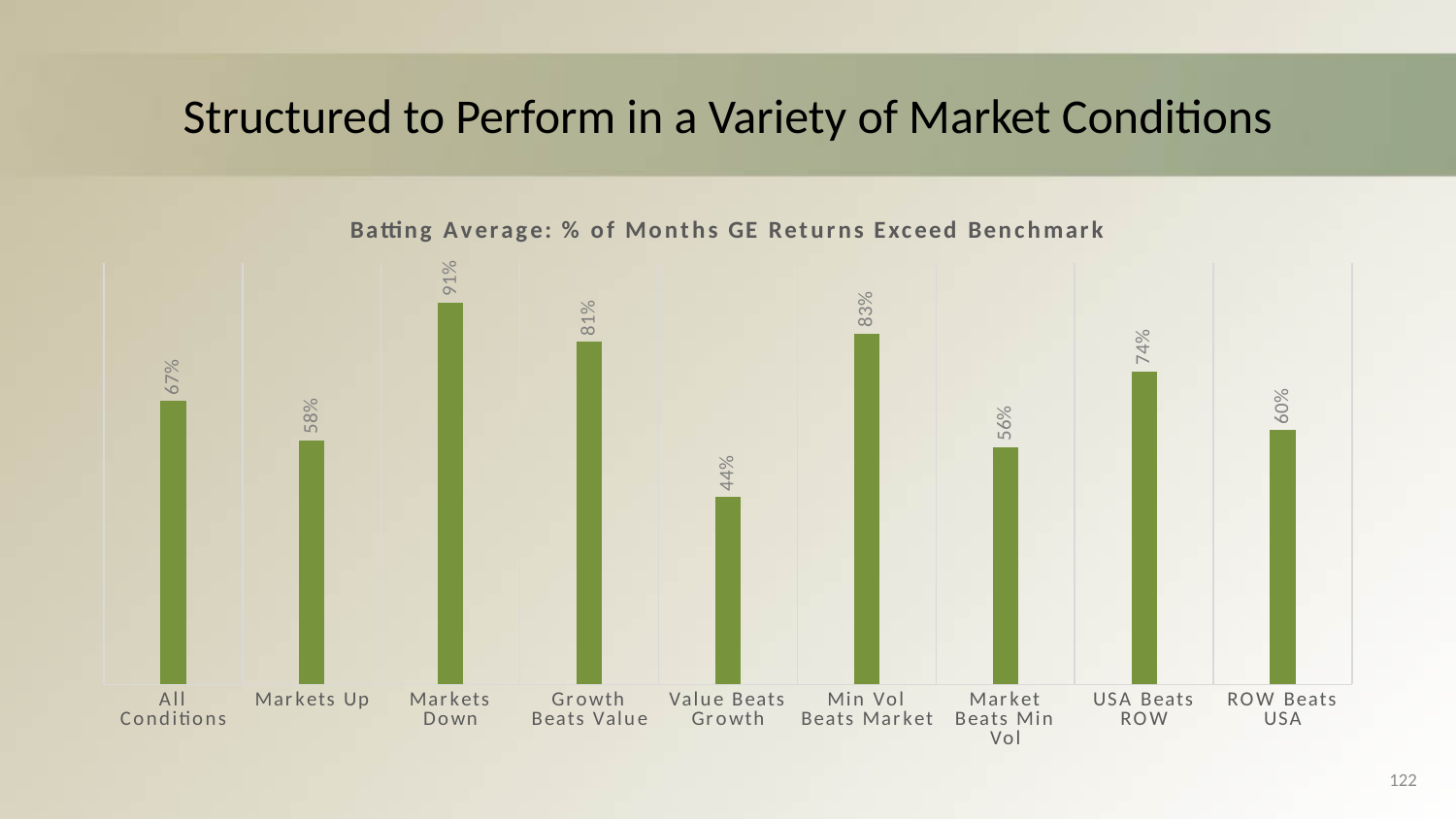
What is the value for USA Beats ROW? 74% What is the difference between the values for Min Vol Beats Market and Market Beats Min Vol? 27% What is the difference between the values for Markets Down and Markets Up? 33% What is the value for Markets Down? 91% How many categories are shown in the chart? 9 What is the title of the chart? Batting Average: % of Months GE Returns Exceed Benchmark Which category has the highest value? Markets Down What is the value for All Conditions? 67% Which category has the lowest value? Value Beats Growth What kind of chart is shown on the slide? Bar chart Which is larger, the value for Growth Beats Value or the value for ROW Beats USA? Growth Beats Value What is the value for Value Beats Growth? 44%